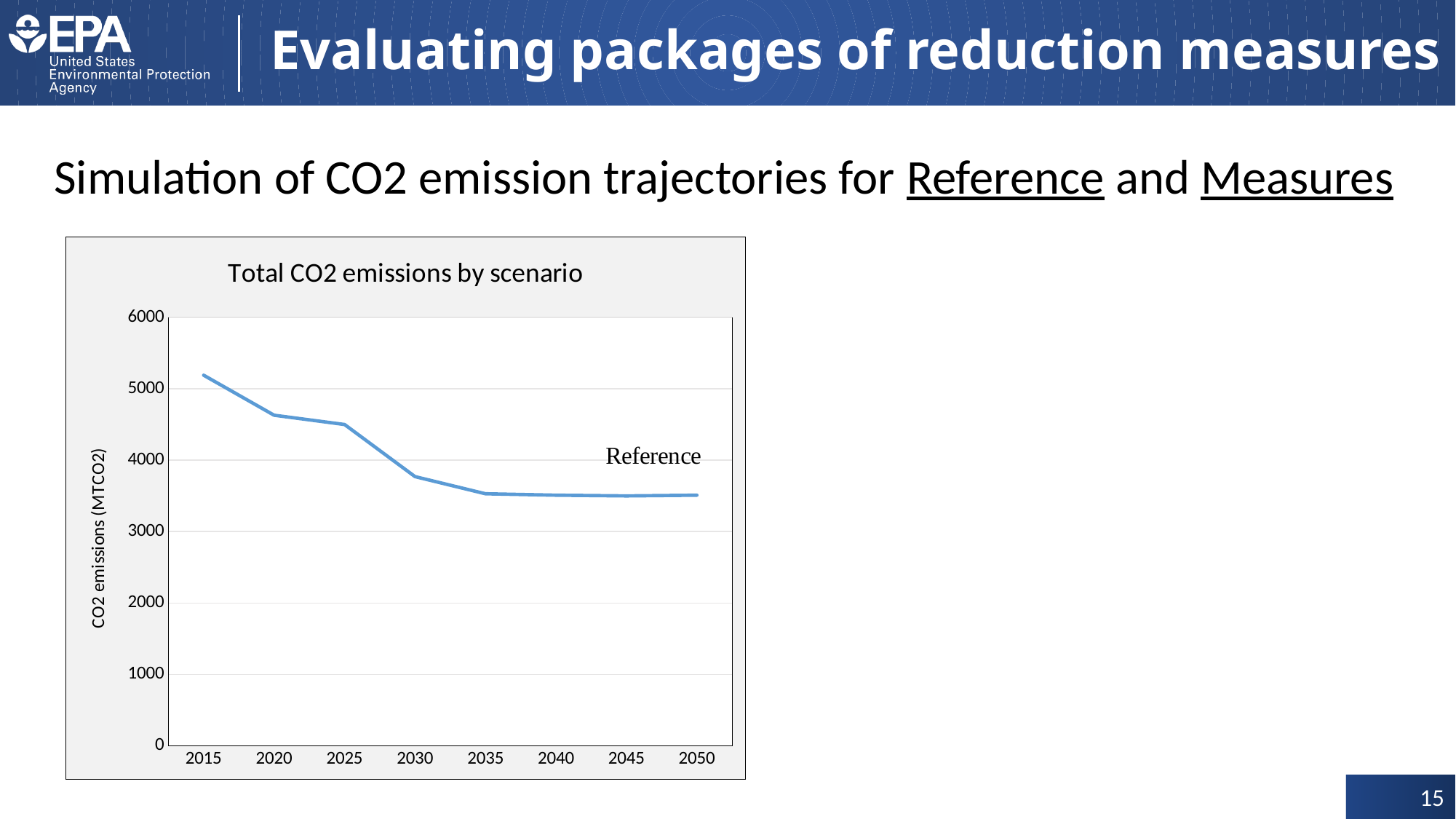
What kind of chart is shown on the slide? line chart Is the value for 2030 greater or less than 4000? less Which year has the highest CO2 emissions in the chart? 2015 Is the value for 2015 greater or less than 5000? greater Do the CO2 emissions rise or fall from 2015 to 2035? fall Is the value for 2020 greater or less than 5000? less How many years are marked along the x axis of the chart? 8 Which is larger, the value for 2025 or the value for 2030? 2025 What is the title of the chart? Total CO2 emissions by scenario What is the label on the vertical axis of the chart? CO2 emissions (MTCO2) What is the name of the scenario plotted on the chart? Reference